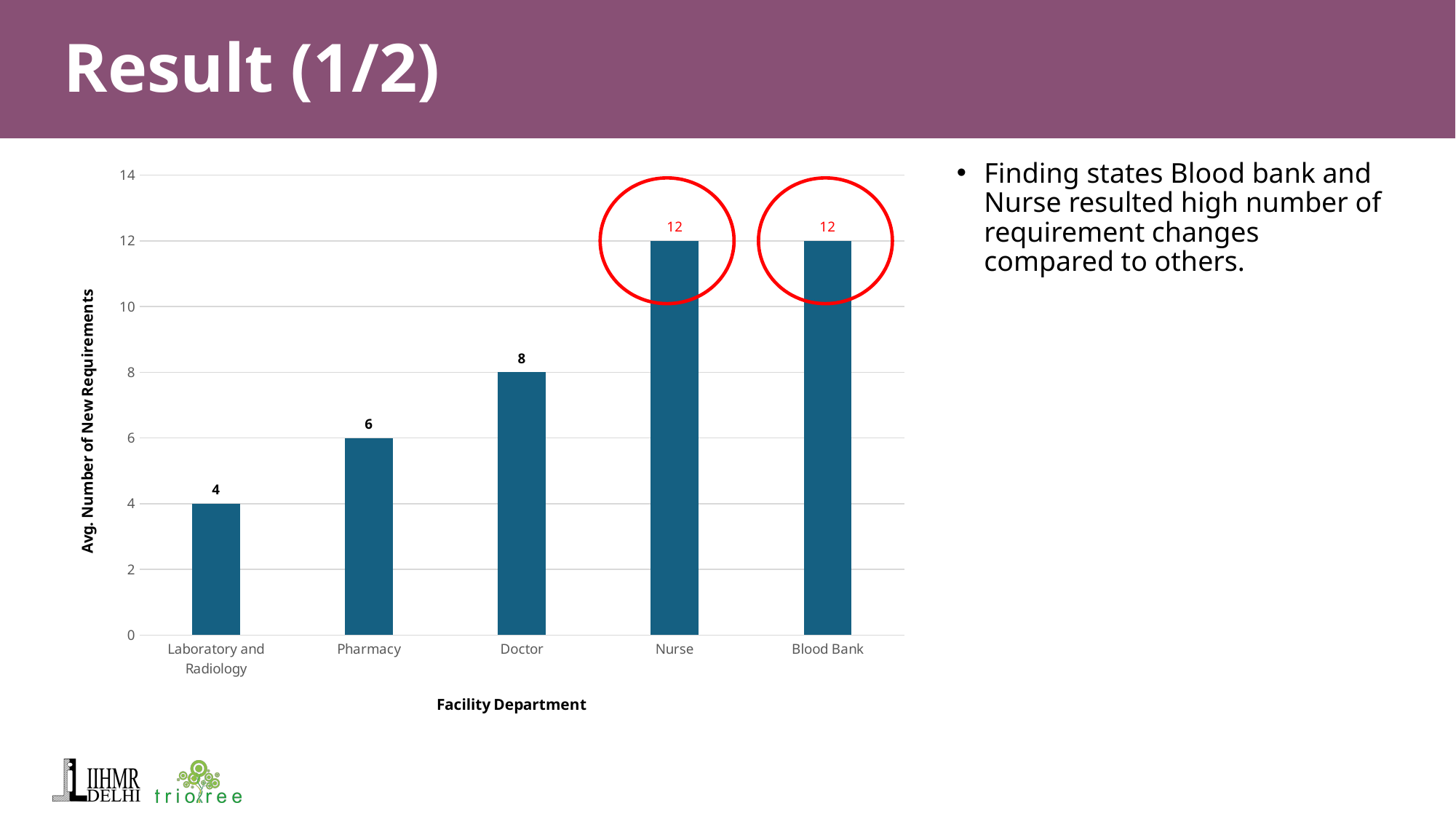
Which facility department has the lowest average number of new requirements? Laboratory and Radiology How many facility departments are shown on the x axis? 5 What is the average number of new requirements for Pharmacy? 6 Which is larger, the value for Doctor or the value for Pharmacy? Doctor What kind of chart is shown on the slide? Bar chart What is the average number of new requirements for Doctor? 8 What is the average number of new requirements for Laboratory and Radiology? 4 Do the values rise or fall from Laboratory and Radiology to Nurse along the x axis? Rise What is the label of the y axis? Avg. Number of New Requirements What is the difference between the values for Pharmacy and Laboratory and Radiology? 2 What is the difference between the values for Nurse and Doctor? 4 What is the average number of new requirements for Blood Bank? 12